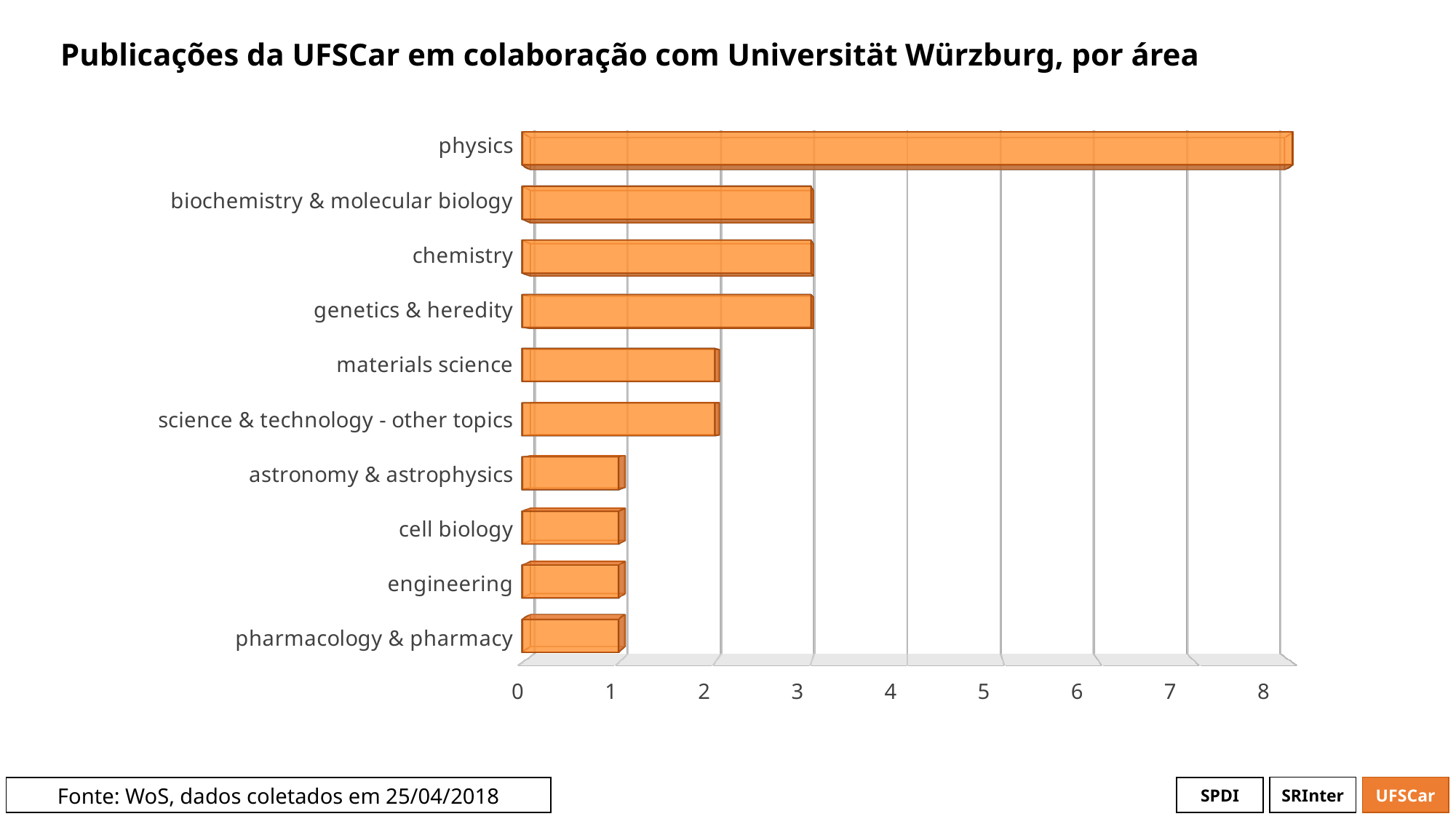
What kind of chart is shown on the slide? bar chart Is the value for cell biology greater or less than 2? less How many areas (categories) are shown in the chart? 10 What is the title of the chart? Publicações da UFSCar em colaboração com Universität Würzburg, por área Which is larger, the value for physics or the value for chemistry? physics Which area has the highest number of publications? physics Is the value for physics greater or less than 7? greater What is the value for materials science? 2 What is the value for engineering? 1 What is the value for biochemistry & molecular biology? 3 What is the difference between the value for physics and the value for materials science? 6 What is the value for physics? 8